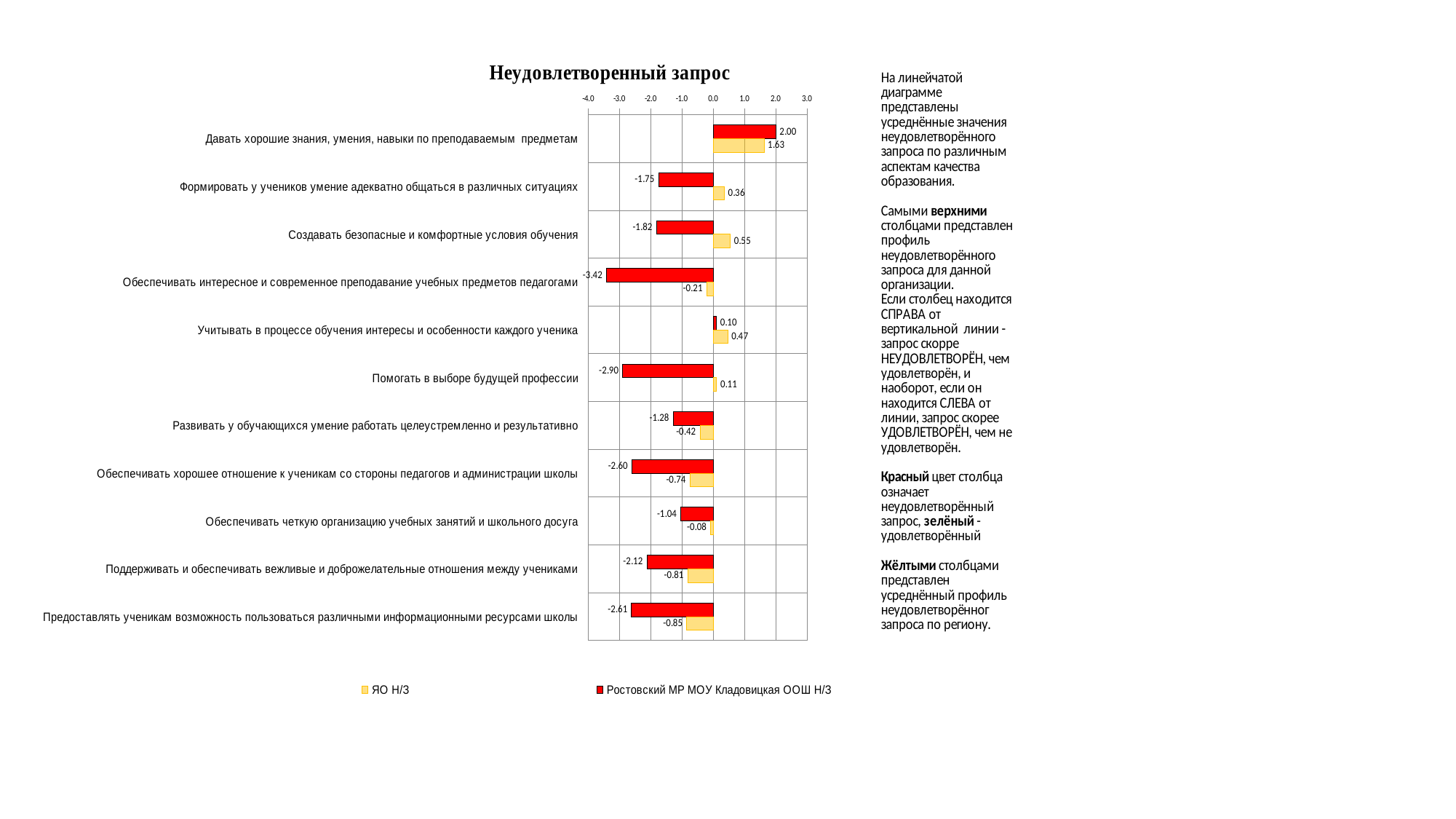
What is the value for the series 'ЯО Н/З' in the category 'Создавать безопасные и комфортные условия обучения'? 0.55 What is the value for the series 'Ростовский МР МОУ Кладовицкая ООШ Н/З' in the category 'Давать хорошие знания, умения, навыки по преподаваемым предметам'? 2.00 Which category has the highest value for the series 'ЯО Н/З'? Давать хорошие знания, умения, навыки по преподаваемым предметам What kind of chart is shown on the slide? Bar chart How many series does the legend list? 2 How many categories are shown on the chart? 11 What is the value for the series 'Ростовский МР МОУ Кладовицкая ООШ Н/З' in the category 'Помогать в выборе будущей профессии'? -2.90 What is the difference between the two series' values in the category 'Давать хорошие знания, умения, навыки по преподаваемым предметам'? 0.37 Which category has the lowest value for the series 'Ростовский МР МОУ Кладовицкая ООШ Н/З'? Обеспечивать интересное и современное преподавание учебных предметов педагогами In the category 'Учитывать в процессе обучения интересы и особенности каждого ученика', which series has the larger value? ЯО Н/З What is the title of the chart? Неудовлетворенный запрос What is the value for the series 'ЯО Н/З' in the category 'Предоставлять ученикам возможность пользоваться различными информационными ресурсами школы'? -0.85